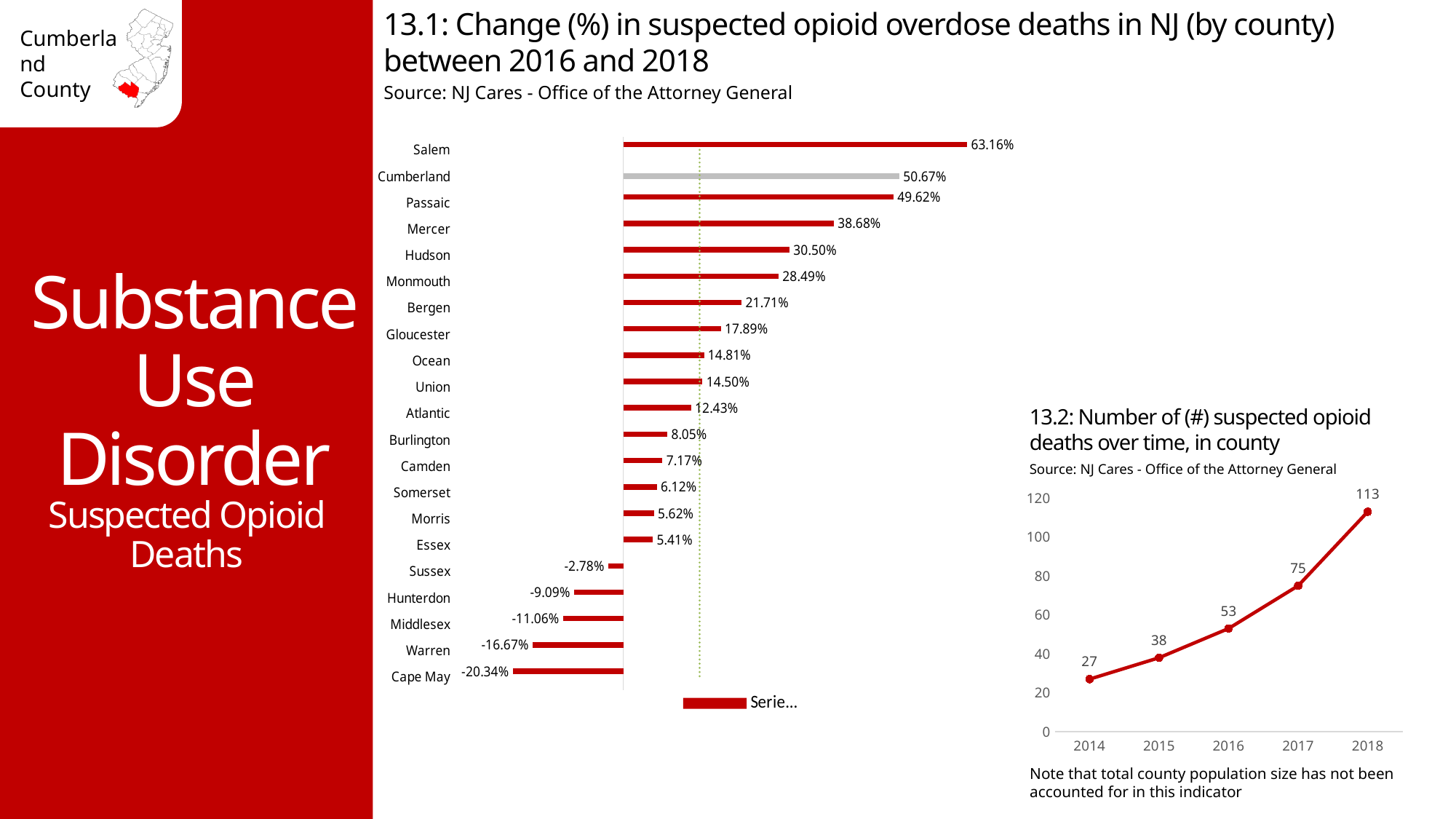
In chart 13.1, which has a larger change (%): Hudson or Bergen? Hudson In chart 13.1, what is the value shown for Mercer? 38.68% In chart 13.1, what is the difference in percentage points between Salem (63.16%) and Passaic (49.62%)? 13.54 In chart 13.2, what is the difference between the number of suspected opioid deaths in 2018 and in 2014? 86 In chart 13.2, do the values rise or fall from 2014 to 2018? Rise In chart 13.1, what is the change (%) in suspected opioid overdose deaths for Cumberland county? 50.67% In chart 13.2, how many suspected opioid deaths were there in 2018? 113 In chart 13.1, which county has the lowest change (%) in suspected opioid overdose deaths? Cape May In chart 13.1, which county has the highest change (%) in suspected opioid overdose deaths? Salem In chart 13.2, how many years are plotted? 5 What kind of chart is chart 13.1? Bar chart In chart 13.1, how many counties are shown? 21